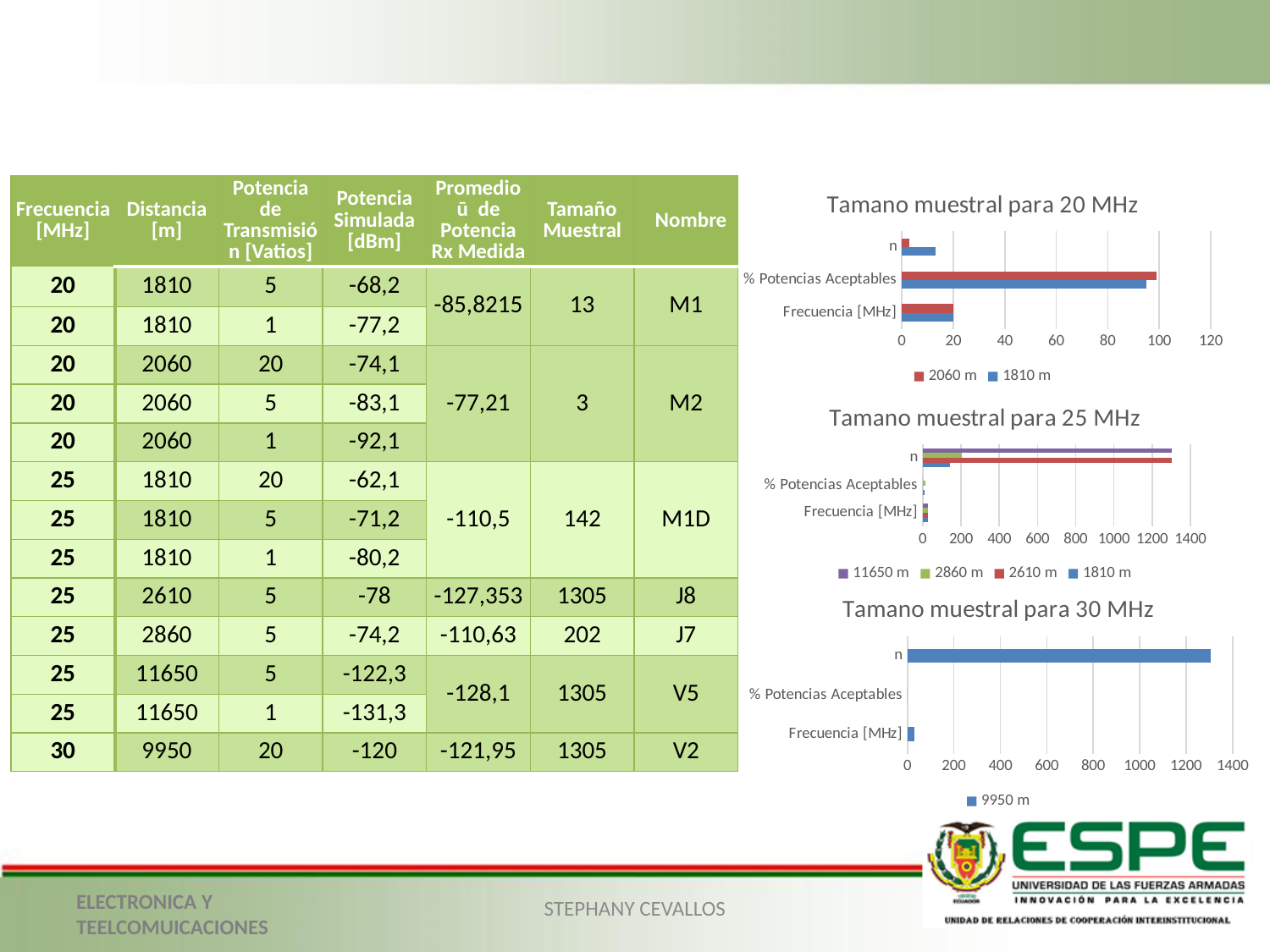
In "Tamano muestral para 30 MHz", is the value for Frecuencia [MHz] greater or less than 200? less How many series does the legend of "Tamano muestral para 20 MHz" list? 2 In "Tamano muestral para 20 MHz", is the n value for 1810 m greater or less than 20? less In "Tamano muestral para 30 MHz", is the value for n greater or less than 1200? greater How many categories are shown on the y axis of "Tamano muestral para 30 MHz"? 3 What kind of chart is "Tamano muestral para 20 MHz"? bar chart In "Tamano muestral para 30 MHz", which category has the longest bar? n What is the only series listed in the legend of "Tamano muestral para 30 MHz"? 9950 m How many series does the legend of "Tamano muestral para 25 MHz" list? 4